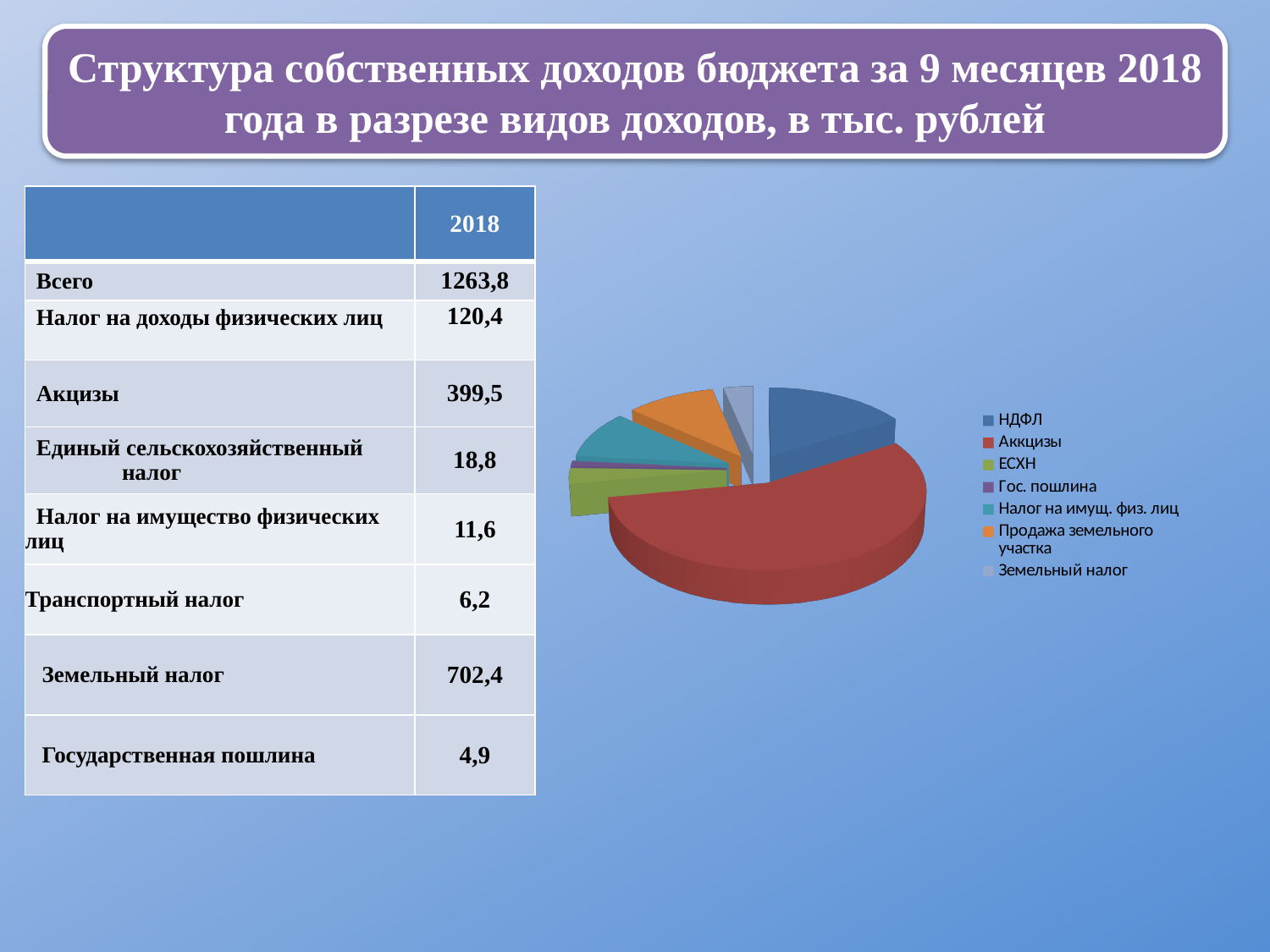
Which category has the smallest slice in the pie chart? Гос. пошлина What kind of chart is shown on the slide? pie chart In the pie chart, which slice is larger: Продажа земельного участка or Гос. пошлина? Продажа земельного участка Which legend entry is shown in orange in the pie chart? Продажа земельного участка What colour represents Аккцизы in the pie chart? red In the pie chart, which slice is larger: Аккцизы or НДФЛ? Аккцизы How many categories does the pie chart's legend list? 7 In the pie chart, which slice is larger: НДФЛ or ЕСХН? НДФЛ Which category has the largest slice in the pie chart? Аккцизы